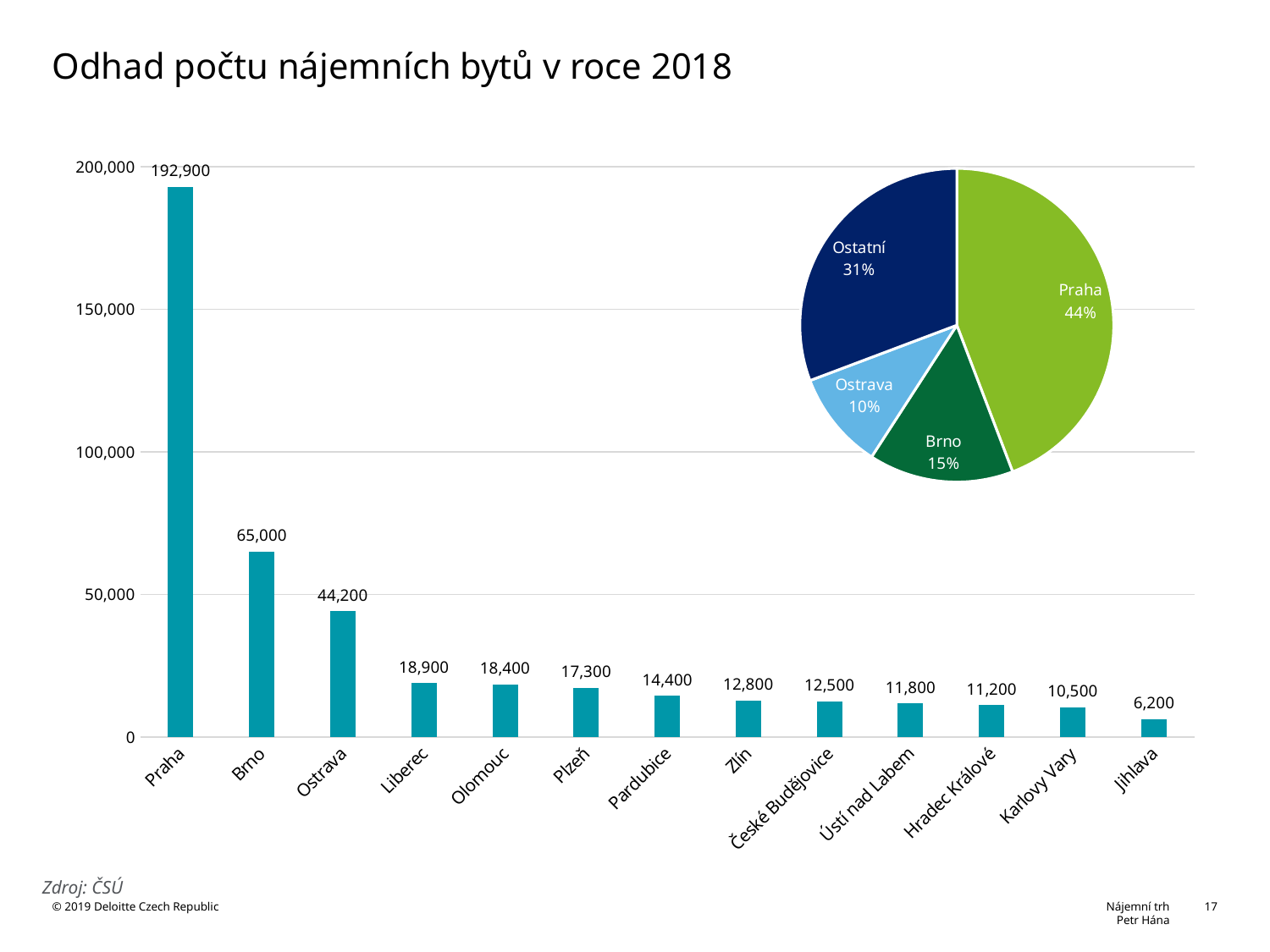
What kind of chart is the chart on the left of the slide? bar chart In the bar chart, which is larger, the value for Ostrava or the value for Liberec? Ostrava In the bar chart, what is the difference between the values for Praha and Brno? 127,900 In the bar chart, do the values rise or fall from left to right along the x axis? fall In the pie chart, what share does Praha have? 44% In the bar chart, which city has the highest value? Praha In the bar chart, what is the value for Brno? 65,000 In the bar chart, what is the value for Olomouc? 18,400 How many slices does the pie chart have? 4 In the bar chart, is the value for Ostrava greater or less than 50,000? less How many cities are shown in the bar chart? 13 In the bar chart, which city has the lowest value? Jihlava